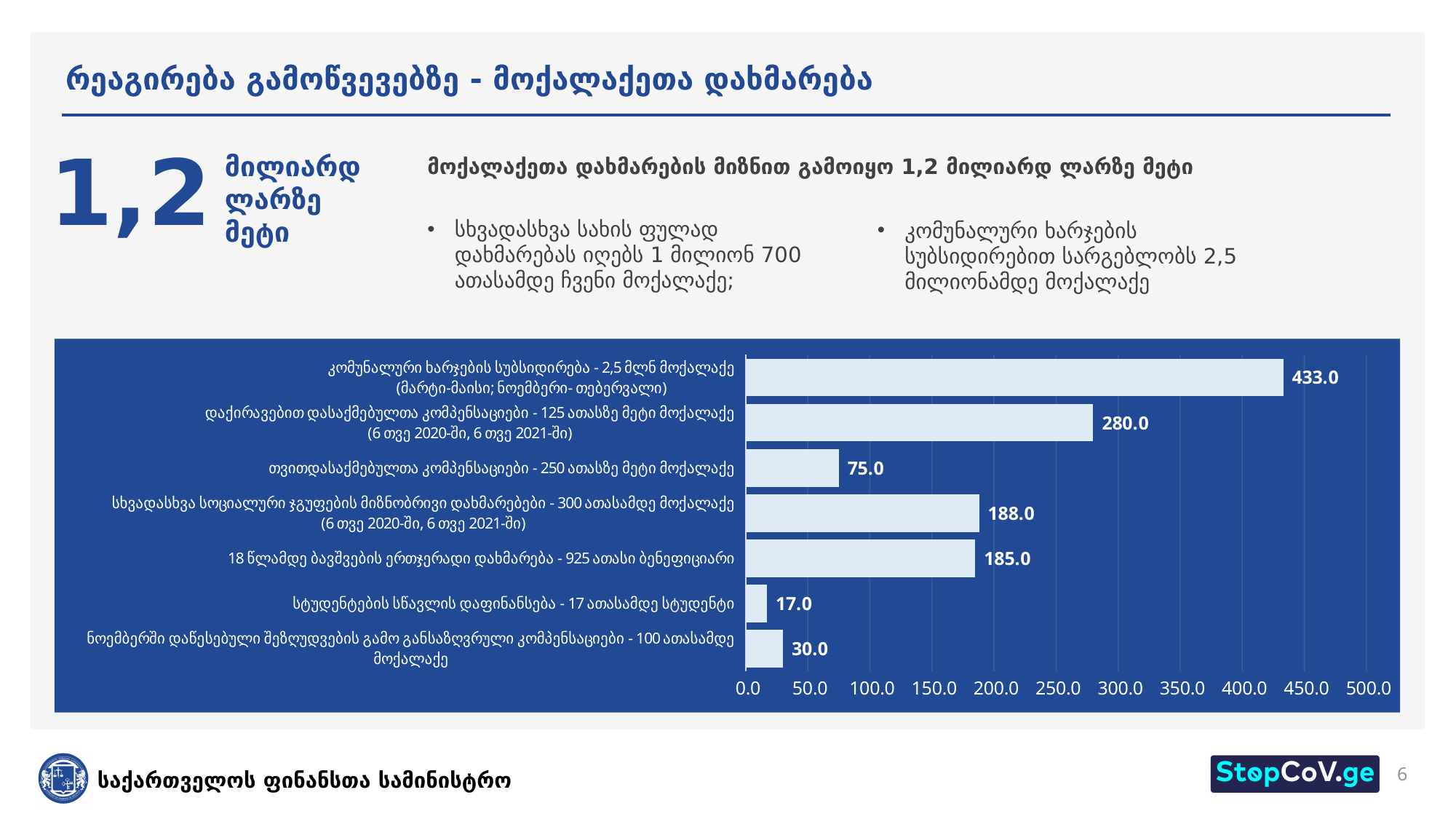
What type of chart is shown on the slide? bar chart Which category has the highest value? კომუნალური ხარჯების სუბსიდირება - 2,5 მლნ მოქალაქე How many categories (bars) does the chart show? 7 What is the value for "თვითდასაქმებულთა კომპენსაციები - 250 ათასზე მეტი მოქალაქე"? 75.0 What is the value for "დაქირავებით დასაქმებულთა კომპენსაციები - 125 ათასზე მეტი მოქალაქე"? 280.0 What is the value for "კომუნალური ხარჯების სუბსიდირება - 2,5 მლნ მოქალაქე"? 433.0 Which is larger: the value for "სხვადასხვა სოციალური ჯგუფების მიზნობრივი დახმარებები" or for "თვითდასაქმებულთა კომპენსაციები"? სხვადასხვა სოციალური ჯგუფების მიზნობრივი დახმარებები What is the maximum value shown on the x axis of the chart? 500.0 What is the value for "სტუდენტების სწავლის დაფინანსება - 17 ათასამდე სტუდენტი"? 17.0 What is the difference between the values for "კომუნალური ხარჯების სუბსიდირება" and "დაქირავებით დასაქმებულთა კომპენსაციები"? 153.0 Which category has the lowest value? სტუდენტების სწავლის დაფინანსება - 17 ათასამდე სტუდენტი What is the value for "18 წლამდე ბავშვების ერთჯერადი დახმარება - 925 ათასი ბენეფიციარი"? 185.0